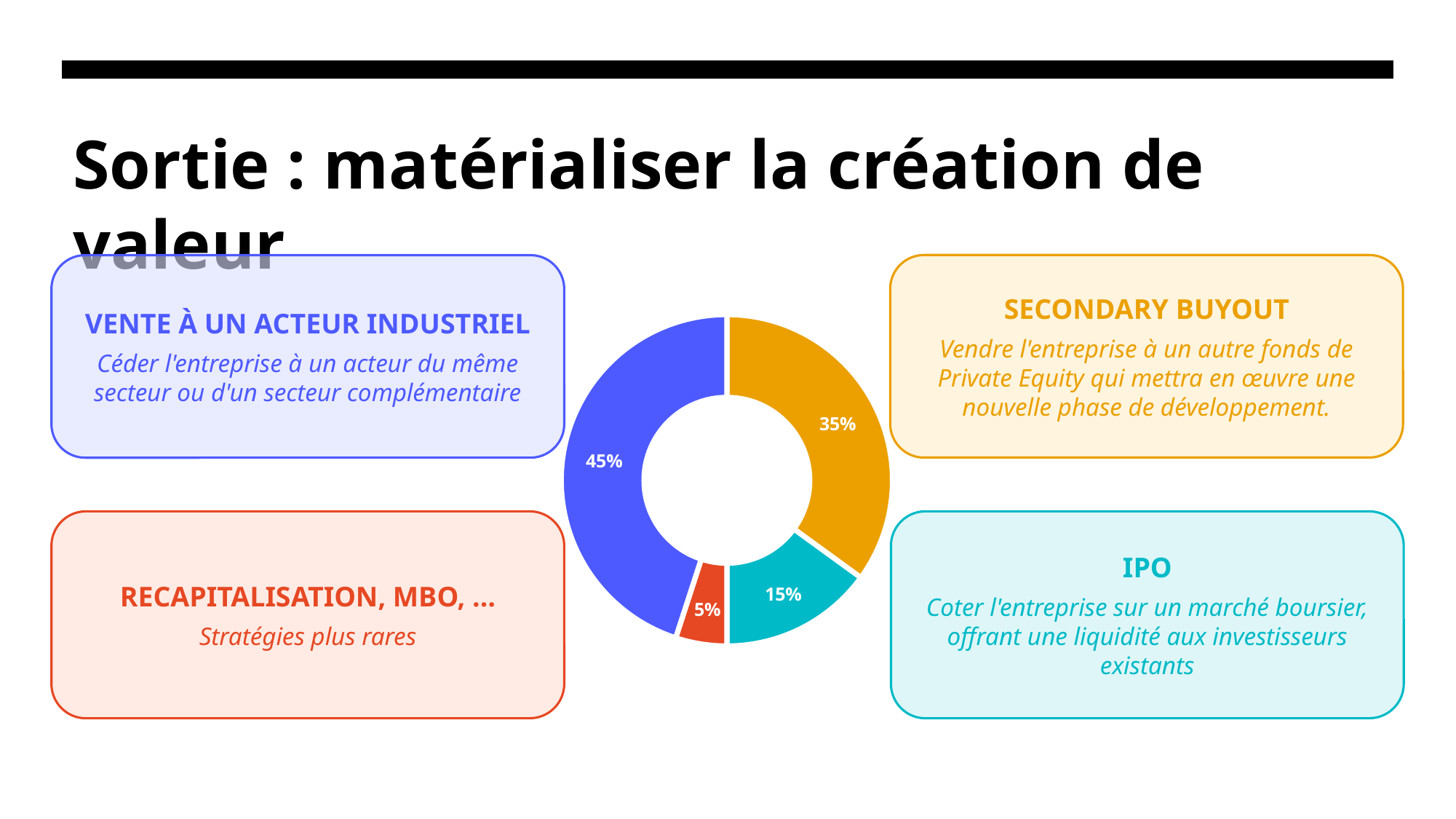
What percentage is shown for the teal slice (IPO)? 15% What percentage is shown for the red slice (Recapitalisation, MBO, ...)? 5% What is the combined share of Secondary buyout and IPO? 50% How many slices does the donut chart have? 4 What percentage is shown for the blue slice (Vente à un acteur industriel)? 45% What kind of chart is shown on the slide? Donut (pie) chart Which exit type has the largest share of the donut chart? Vente à un acteur industriel (45%) Which is larger: the share for IPO or the share for Recapitalisation, MBO, ...? IPO What is the difference between the share for Vente à un acteur industriel and the share for Secondary buyout? 10 percentage points What colour is the slice representing IPO? Teal Which exit type has the smallest share of the donut chart? Recapitalisation, MBO, ... (5%) What percentage is shown for the orange slice (Secondary buyout)? 35%